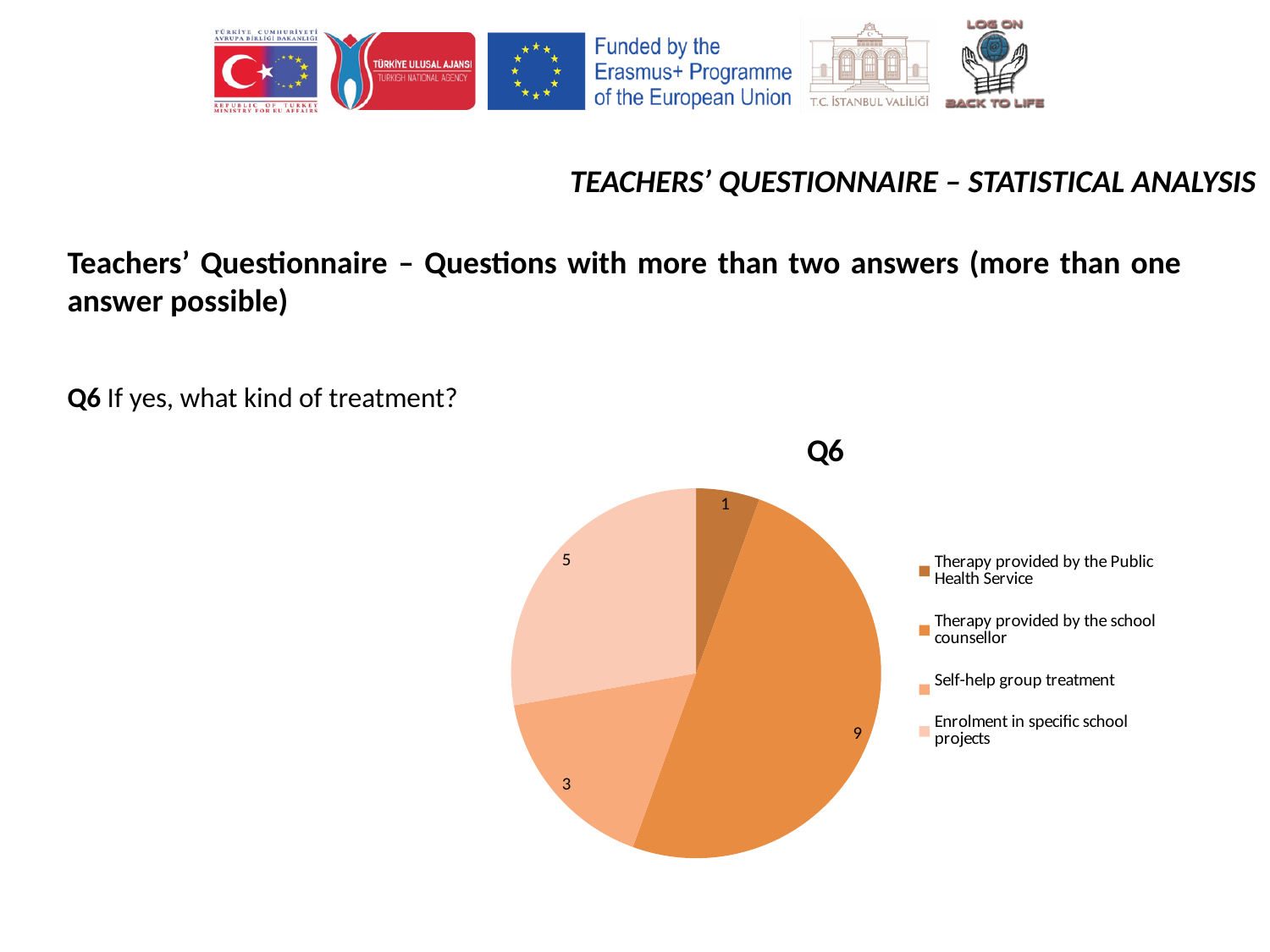
What is the value for 'Self-help group treatment'? 3 What is the difference between the values for 'Therapy provided by the school counsellor' and 'Enrolment in specific school projects'? 4 What share of the pie does 'Therapy provided by the school counsellor' represent? 50% What is the value for 'Enrolment in specific school projects'? 5 How many entries does the legend list? 4 What is the value for 'Therapy provided by the Public Health Service'? 1 How many slices does the pie chart have? 4 What is the value for 'Therapy provided by the school counsellor'? 9 Which category has the smallest slice? Therapy provided by the Public Health Service Which category has the largest slice? Therapy provided by the school counsellor What is the title of the chart? Q6 What type of chart is shown on the slide? pie chart